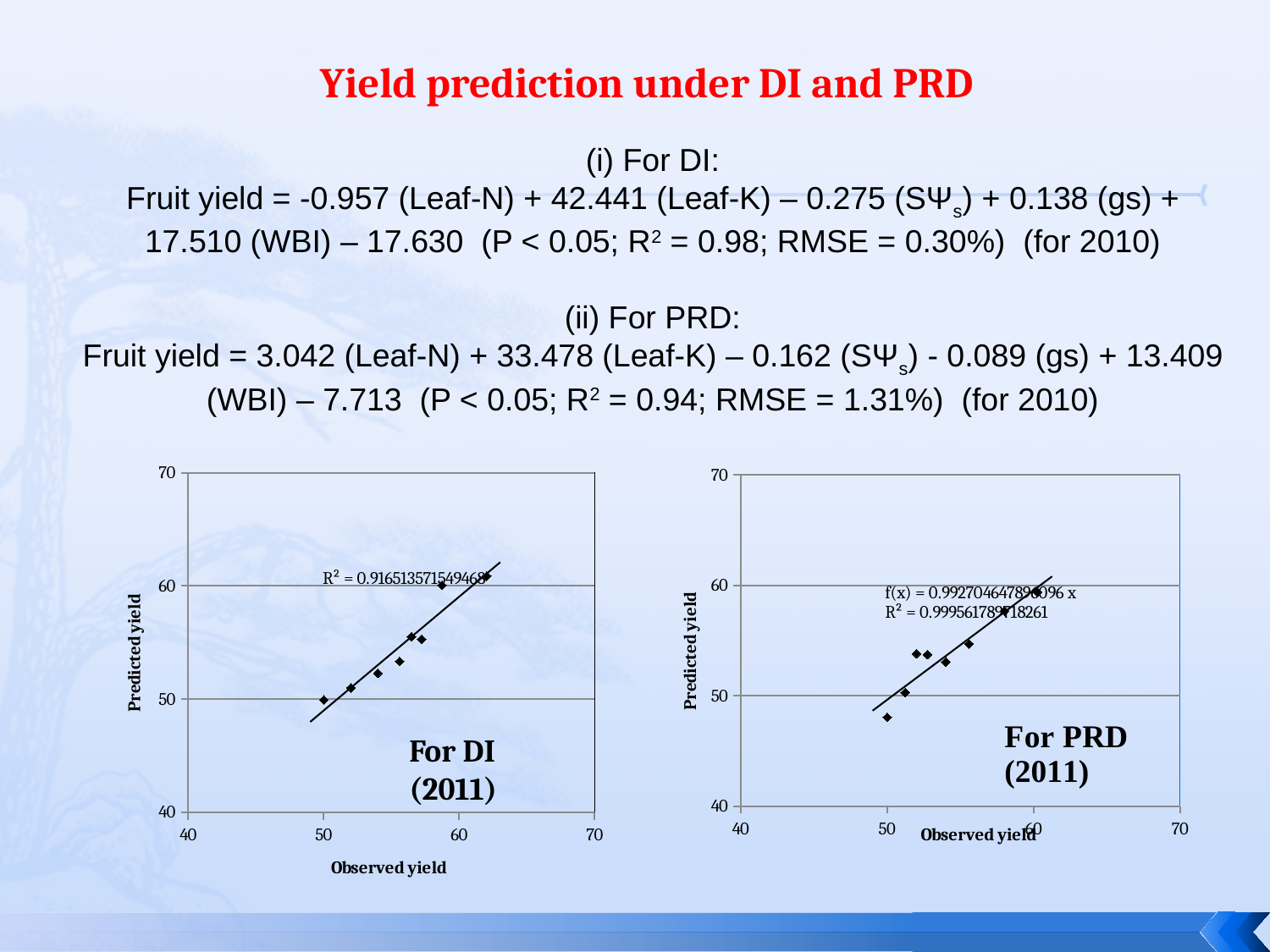
What kind of chart is the For DI (2011) chart? Scatter chart Which chart shows the higher R² value for its trendline, For DI (2011) or For PRD (2011)? For PRD (2011) On the For PRD (2011) chart, is the lowest plotted predicted yield greater or less than 50? less What is the title of the y axis on the For DI (2011) chart? Predicted yield What is the lowest value shown on the x axis of the For DI (2011) chart? 40 On the For DI (2011) chart, does predicted yield rise or fall as observed yield increases? Rise What is the title of the x axis on the For PRD (2011) chart? Observed yield On the For DI (2011) chart, is the lowest plotted predicted yield greater or less than 60? less On the For PRD (2011) chart, does predicted yield rise or fall as observed yield increases? Rise On the For DI (2011) chart, is the R² value shown greater or less than 0.9? greater What is the highest value shown on the y axis of the For PRD (2011) chart? 70